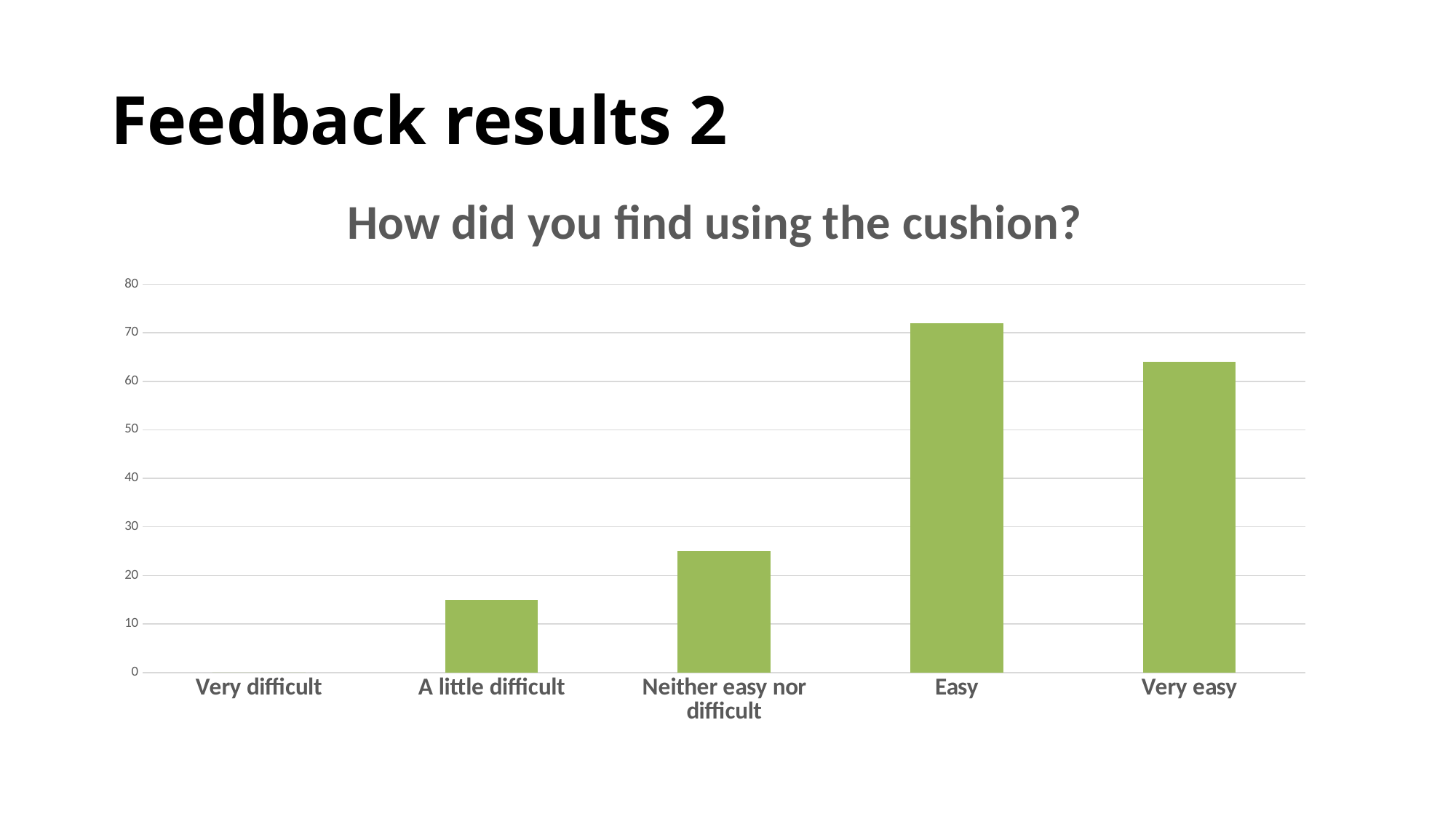
Which category has the lowest value? Very difficult Is the value for A little difficult greater or less than 20? less Do the values rise or fall from Very difficult to Easy along the x axis? rise Which is larger, the value for Easy or the value for Very easy? Easy Which is larger, the value for A little difficult or the value for Neither easy nor difficult? Neither easy nor difficult Is the value for Very easy greater or less than 60? greater How many categories are shown on the x axis of the chart? 5 Is the value for Neither easy nor difficult greater or less than 20? greater What kind of chart is shown on the slide? bar chart Which category has the highest value? Easy What is the title of the chart? How did you find using the cushion?